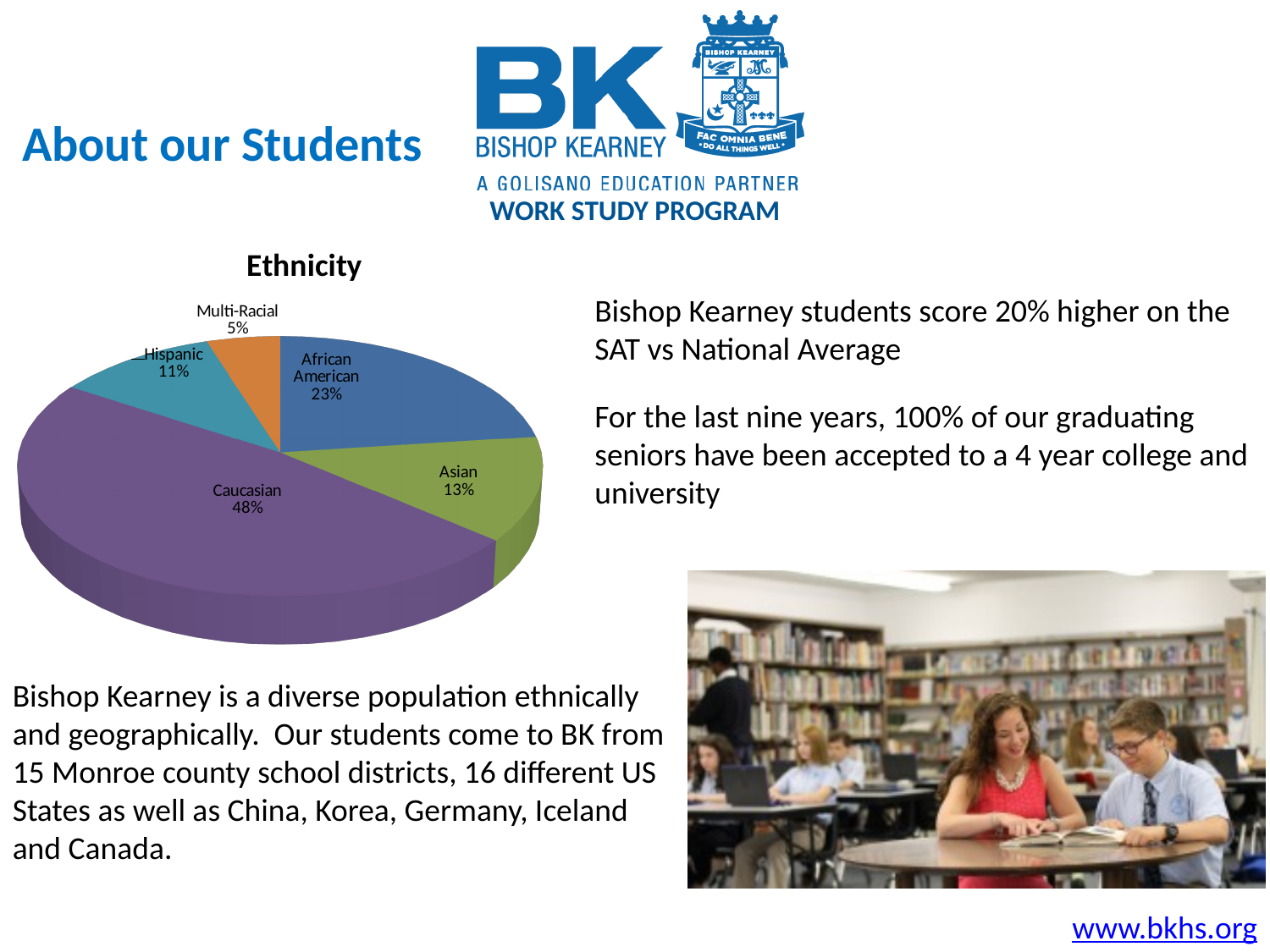
How many ethnicity categories are shown in the pie chart? 5 What percentage of students are Caucasian according to the Ethnicity chart? 48% What is the difference in percentage points between the Caucasian and African American slices? 25 What type of chart is shown under the title "Ethnicity"? Pie chart Which ethnicity has the largest share in the Ethnicity chart? Caucasian Which ethnicity has the smallest share in the Ethnicity chart? Multi-Racial What percentage of students are Hispanic according to the Ethnicity chart? 11% What percentage of students are African American according to the Ethnicity chart? 23% What percentage of students are Asian according to the Ethnicity chart? 13% What percentage of students are Multi-Racial according to the Ethnicity chart? 5% Which slice is larger in the Ethnicity chart, Asian or Hispanic? Asian What is the title of the chart? Ethnicity